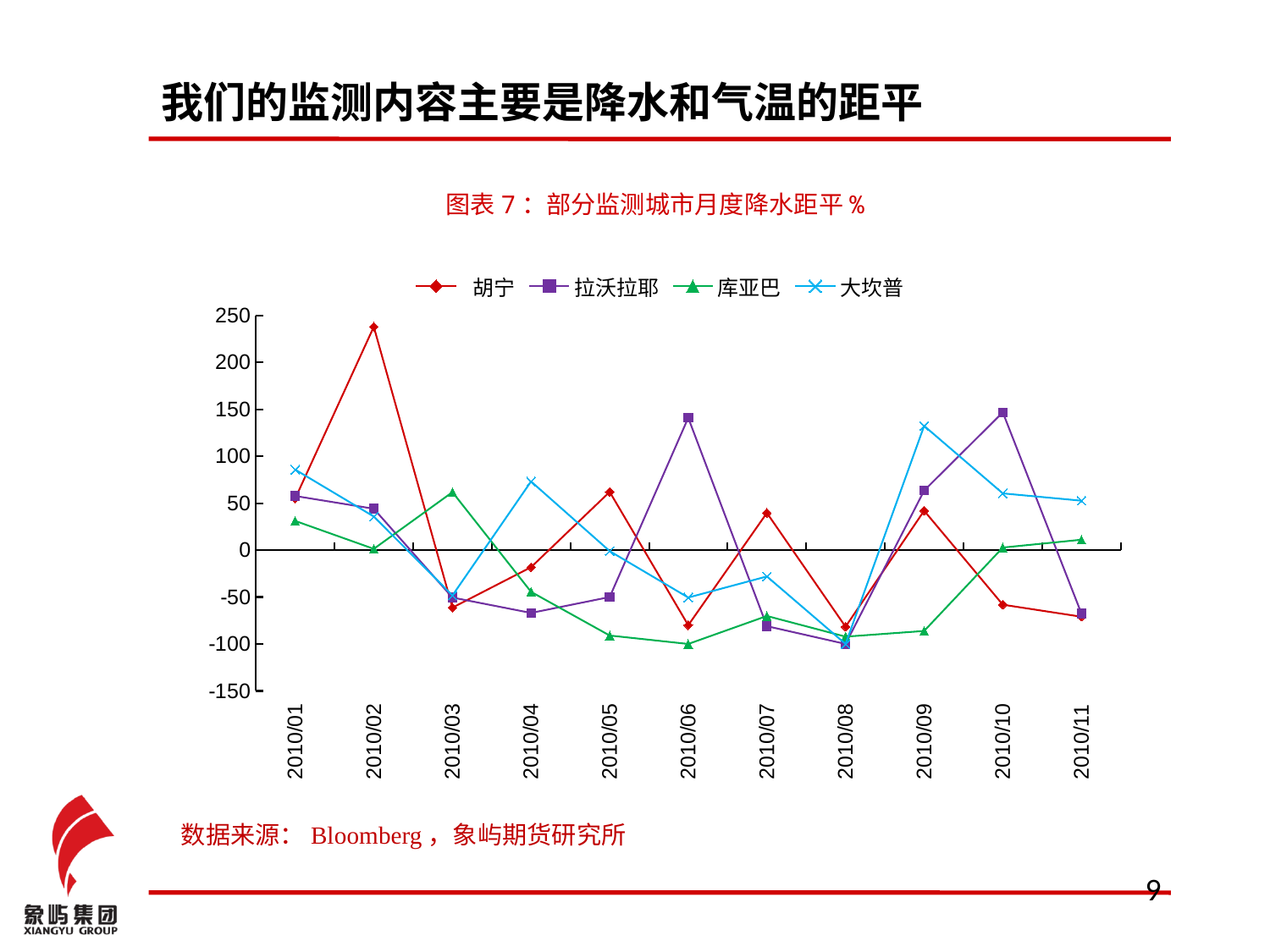
What kind of chart is shown on the slide? line chart How many months are plotted along the x axis? 11 In which month does 大坎普 reach its highest value? 2010/09 Does the value for 大坎普 rise or fall from 2010/09 to 2010/11? fall Is the value for 胡宁 in 2010/02 greater or less than 200? greater How many series does the legend list? 4 In which month does 大坎普 reach its lowest value? 2010/08 What is the title of the chart? 图表 7：部分监测城市月度降水距平 % In 2010/01, which is larger: the value for 大坎普 or the value for 库亚巴? 大坎普 Is the value for 库亚巴 in 2010/06 greater or less than -50? less In which month does 胡宁 reach its highest value? 2010/02 Is the value for 拉沃拉耶 in 2010/06 greater or less than 100? greater